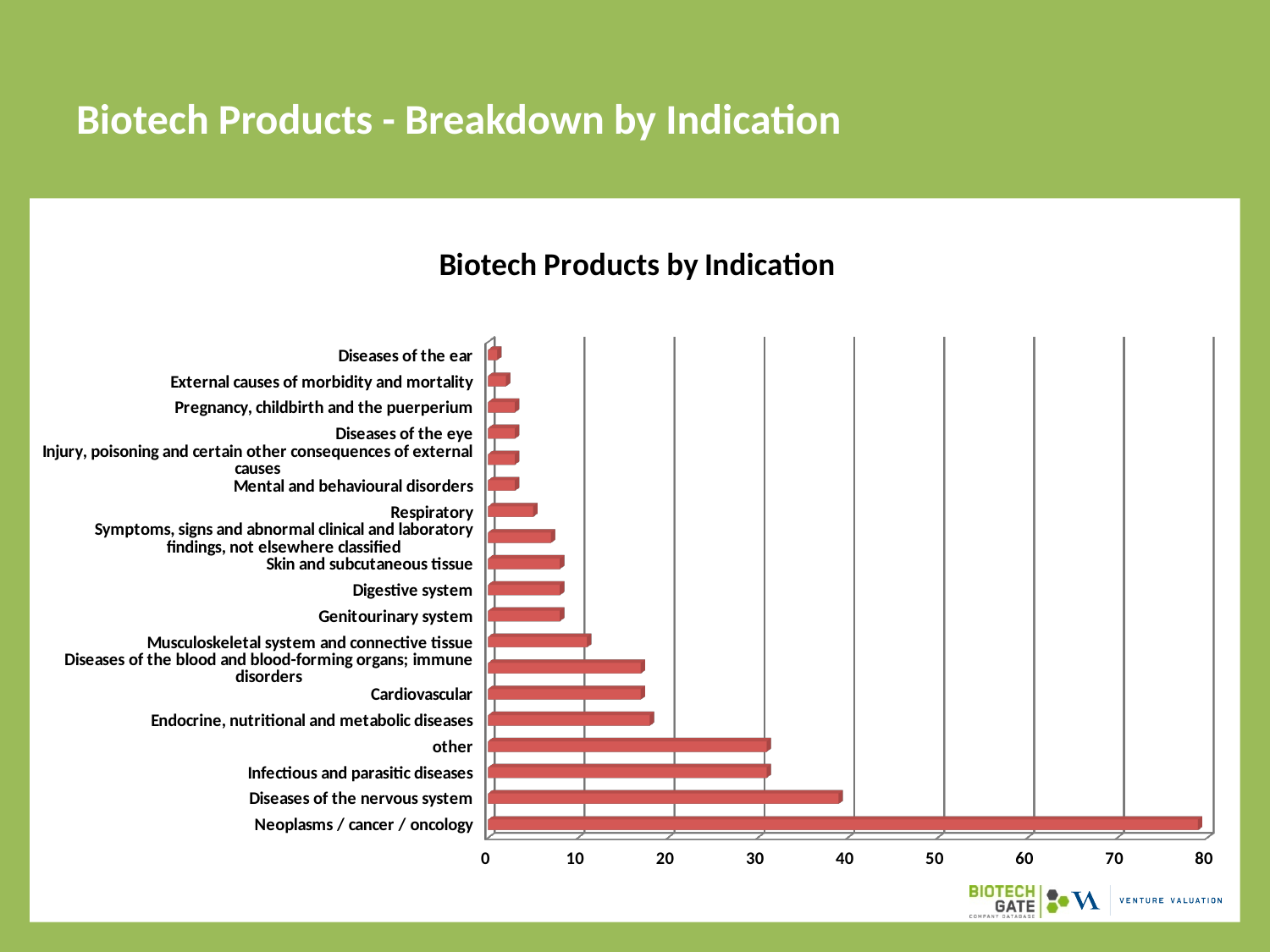
What kind of chart is shown on the slide? bar chart Is the value for Diseases of the nervous system greater or less than 30? greater Which has more biotech products: Musculoskeletal system and connective tissue or Respiratory? Musculoskeletal system and connective tissue Is the value for Respiratory greater or less than 10? less Which indication has the highest number of biotech products? Neoplasms / cancer / oncology How many indication categories are plotted in the chart? 19 What is the title of the chart? Biotech Products by Indication Is the value for Endocrine, nutritional and metabolic diseases greater or less than 20? less Which indication has the lowest number of biotech products? Diseases of the ear Which has more biotech products: Diseases of the nervous system or Infectious and parasitic diseases? Diseases of the nervous system